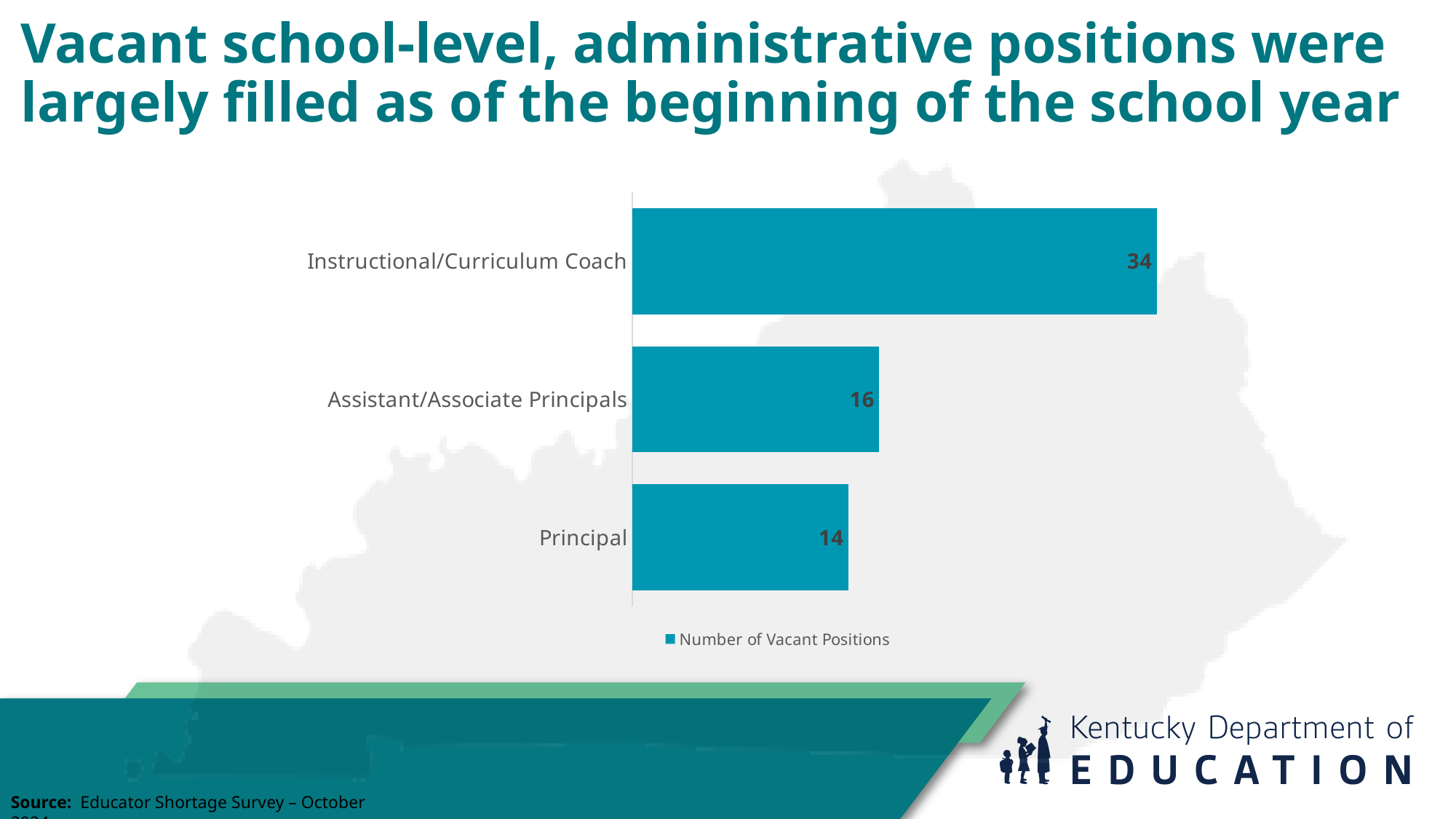
How many categories are shown in the chart? 3 What kind of chart is shown on the slide? Bar chart What is the difference between the number of vacant positions for Assistant/Associate Principals and Principal? 2 How many series does the legend list? 1 What is the legend entry for the series shown in the chart? Number of Vacant Positions Which has more vacant positions, Instructional/Curriculum Coach or Assistant/Associate Principals? Instructional/Curriculum Coach Which category has the lowest number of vacant positions? Principal Which category has the highest number of vacant positions? Instructional/Curriculum Coach What is the number of vacant positions for Principal? 14 What is the number of vacant positions for Assistant/Associate Principals? 16 What is the difference between the number of vacant positions for Instructional/Curriculum Coach and Principal? 20 What is the number of vacant positions for Instructional/Curriculum Coach? 34